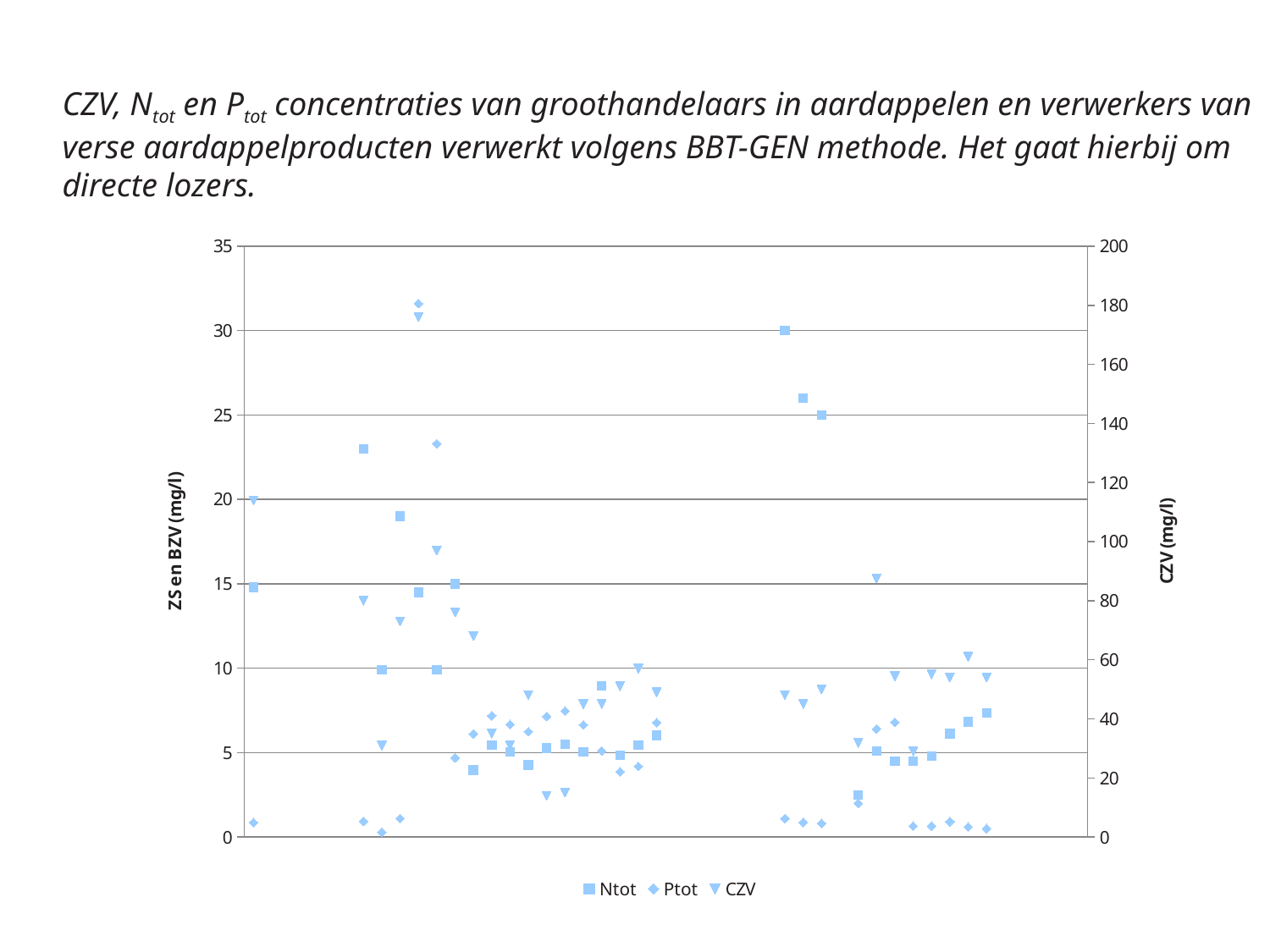
Is the lowest Ptot value greater or less than 5 on the left axis? less What is the title of the right vertical axis? CZV (mg/l) Is the highest Ptot value greater or less than 25 on the left axis? greater Is the highest CZV value greater or less than 160 on the right axis? greater What is the maximum value shown on the left vertical axis? 35 What are the names of the series listed in the legend? Ntot, Ptot, CZV What kind of chart is shown on the slide? scatter chart What is the maximum value shown on the right vertical axis? 200 How many series does the legend list? 3